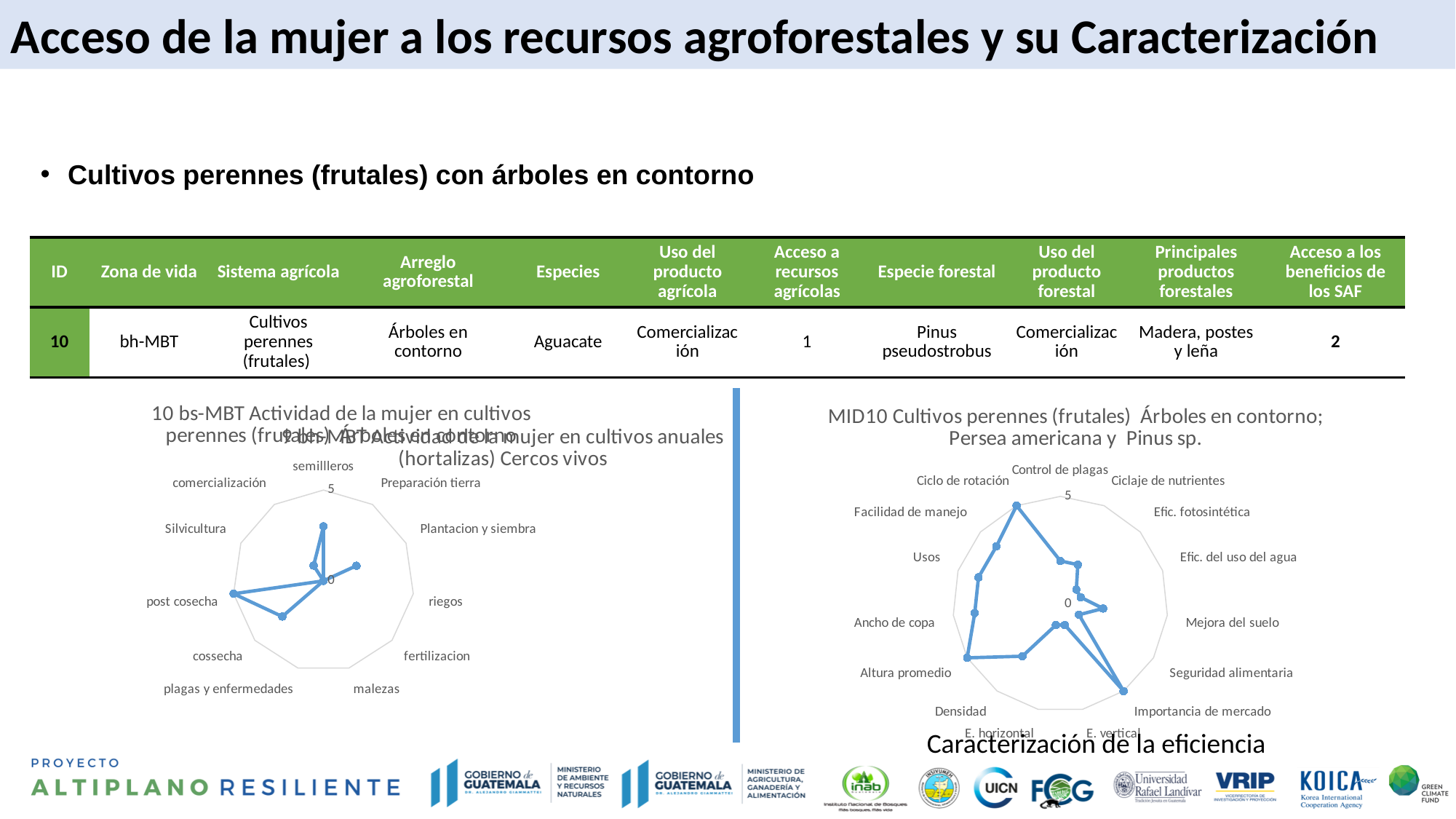
What is the title of the radar chart on the right of the slide? MID10 Cultivos perennes (frutales) Árboles en contorno; Persea americana y Pinus sp. How many categories (axes) does the radar chart on the right of the slide have? 15 What kind of chart is the chart on the left of the slide? radar chart In the radar chart on the right of the slide, which is larger: the value for Importancia de mercado or the value for Mejora del suelo? Importancia de mercado In the radar chart on the right of the slide, is the value for Efic. del uso del agua greater or less than 5? less What is the maximum value shown on the axis scale of the radar chart on the right of the slide? 5 In the radar chart on the right of the slide, is the value for Mejora del suelo greater or less than 5? less In the radar chart on the left of the slide, which is larger: the value for post cosecha or the value for riegos? post cosecha In the radar chart on the left of the slide, which category has the highest value? post cosecha What kind of chart is the chart on the right of the slide? radar chart In the radar chart on the left of the slide, is the value for semilleros greater or less than 5? less How many categories (axes) does the radar chart on the left of the slide have? 11